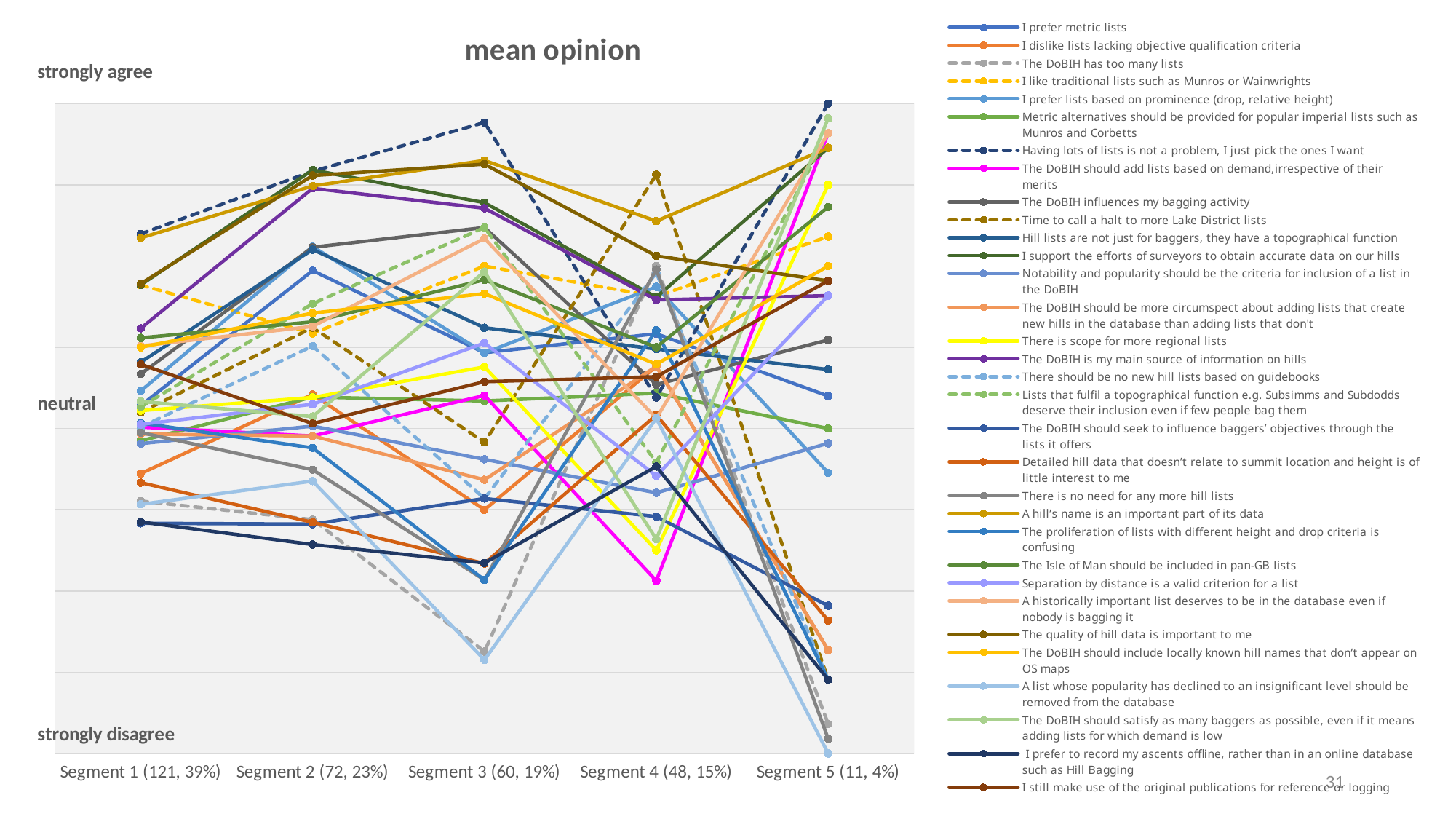
At Segment 5, which series has the larger value: 'Having lots of lists is not a problem, I just pick the ones I want' or 'A list whose popularity has declined to an insignificant level should be removed from the database'? Having lots of lists is not a problem, I just pick the ones I want What is the title of the chart? mean opinion How many segments (categories) are shown along the x axis? 5 How many series does the legend list? 32 Is the value for 'I prefer to record my ascents offline, rather than in an online database such as Hill Bagging' at Segment 1 above or below the neutral line? below Does the series 'Having lots of lists is not a problem, I just pick the ones I want' rise or fall from Segment 1 to Segment 3? rise In which segment does the series 'A list whose popularity has declined to an insignificant level should be removed from the database' reach its lowest value? Segment 5 (11, 4%) What is the label of the first category on the x axis? Segment 1 (121, 39%) In which segment does the series 'The DoBIH has too many lists' reach its lowest value? Segment 5 (11, 4%) In which segment does the series 'Having lots of lists is not a problem, I just pick the ones I want' reach its highest value? Segment 5 (11, 4%) What kind of chart is shown on the slide? line chart In which segment does the series 'Time to call a halt to more Lake District lists' reach its highest value? Segment 4 (48, 15%)